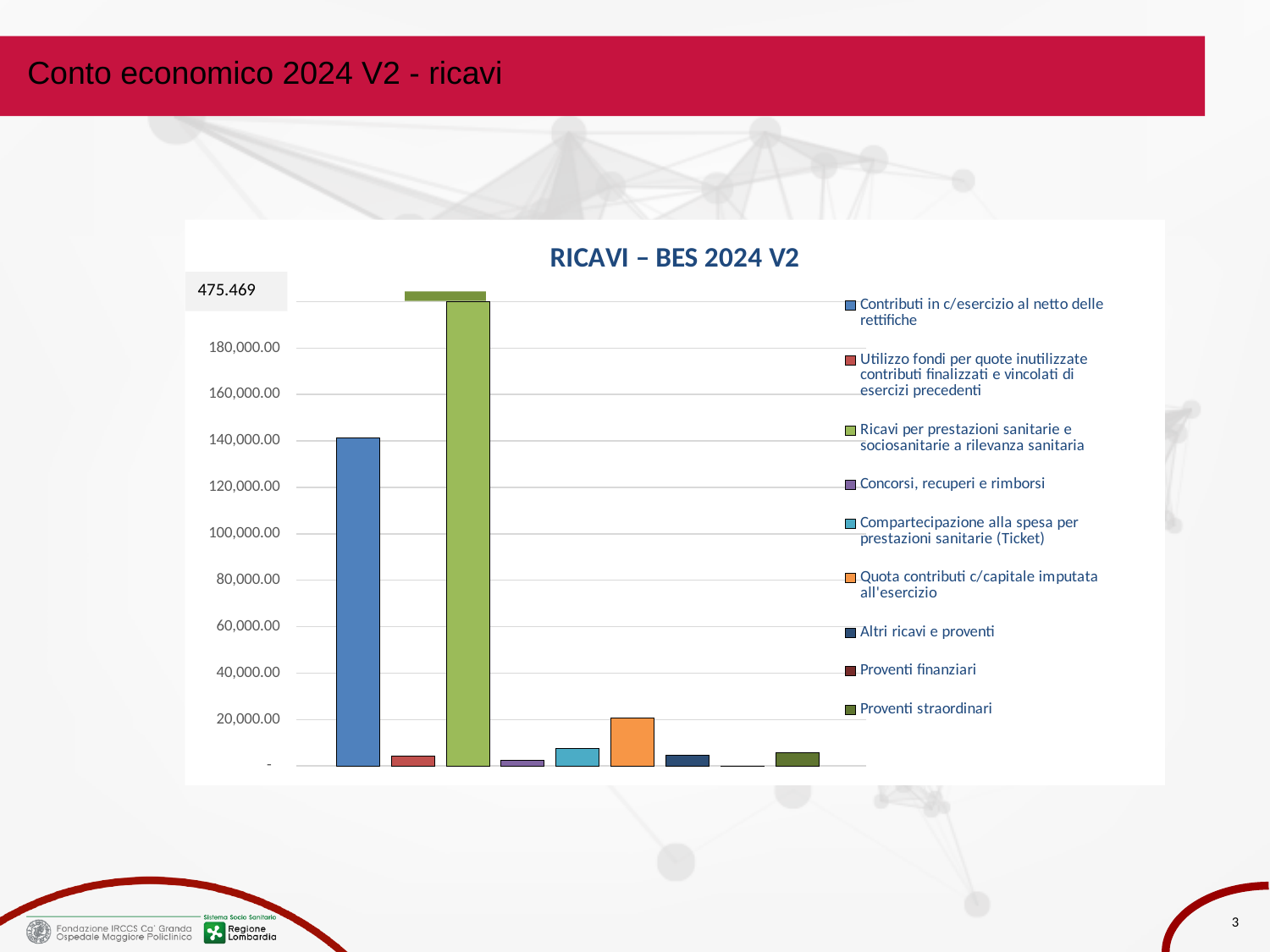
Which series has the lowest value? Proventi finanziari What is the title of the chart? RICAVI – BES 2024 V2 Which is larger: Proventi straordinari or Concorsi, recuperi e rimborsi? Proventi straordinari Is the value for Compartecipazione alla spesa per prestazioni sanitarie (Ticket) greater or less than 20,000.00? less Which series has the highest value? Ricavi per prestazioni sanitarie e sociosanitarie a rilevanza sanitaria How many series does the legend list? 9 Which is larger: Quota contributi c/capitale imputata all'esercizio or Compartecipazione alla spesa per prestazioni sanitarie (Ticket)? Quota contributi c/capitale imputata all'esercizio How many bars are plotted in the chart? 9 Is the value for Quota contributi c/capitale imputata all'esercizio greater or less than 40,000.00? less Is the value for Contributi in c/esercizio al netto delle rettifiche greater or less than 120,000.00? greater What value is printed at the top of the y axis for the tallest bar (Ricavi per prestazioni sanitarie e sociosanitarie a rilevanza sanitaria)? 475.469 What kind of chart is shown on the slide? bar chart